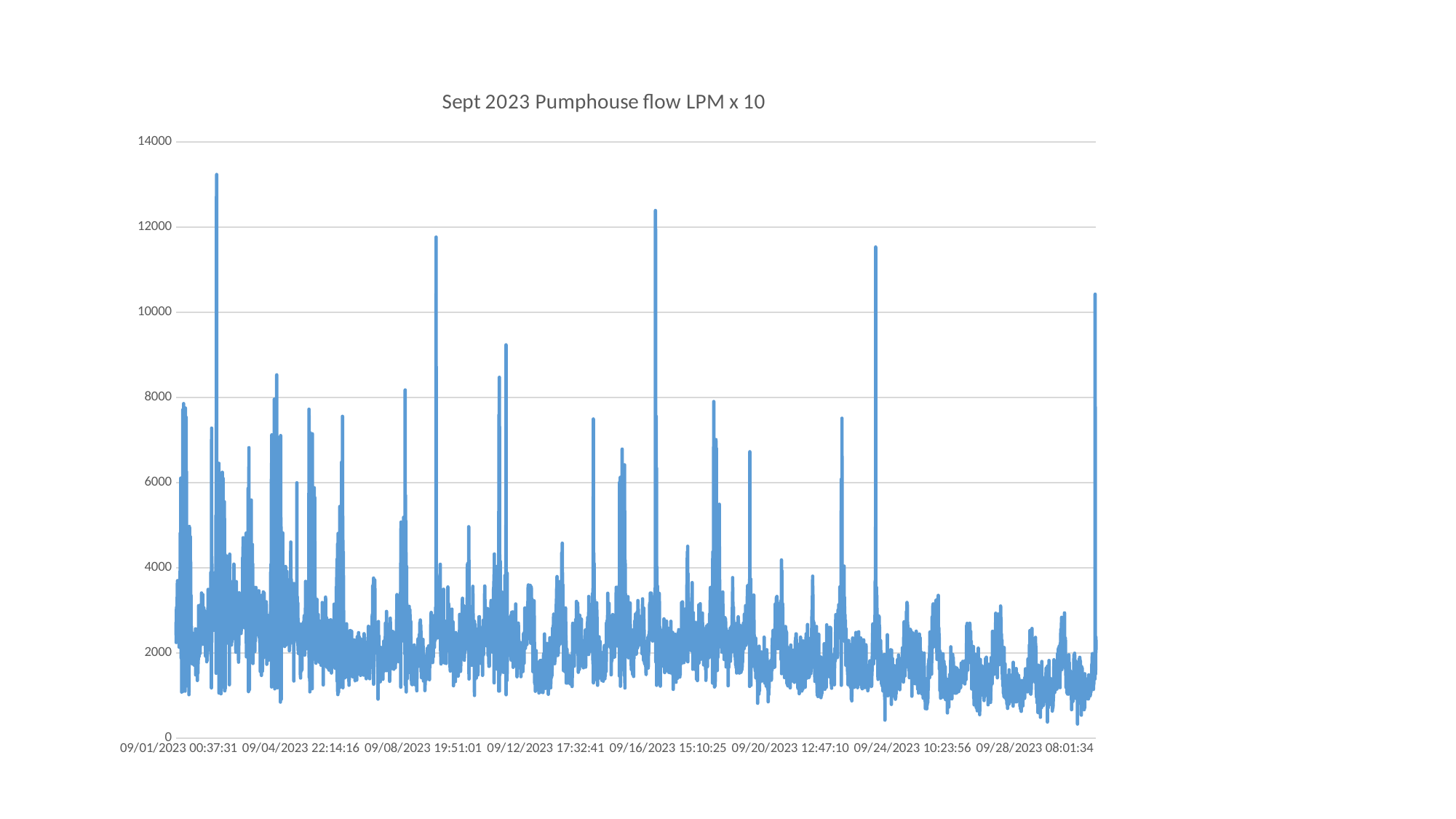
Ignoring the spikes, does the typical level of the line rise or fall from the start of the month to the end? fall How many date labels are printed along the horizontal axis? 8 Is the highest peak on the chart, near the start of the month, greater or less than 12000? greater What is the first date label on the horizontal axis? 09/01/2023 00:37:31 What kind of chart is shown on the slide? line chart What is the highest value shown on the vertical axis? 14000 Is the tall spike just after the 09/16/2023 15:10:25 tick greater or less than 12000? greater Is the spike at the far right end of the chart greater or less than 12000? less What is the title of the chart? Sept 2023 Pumphouse flow LPM x 10